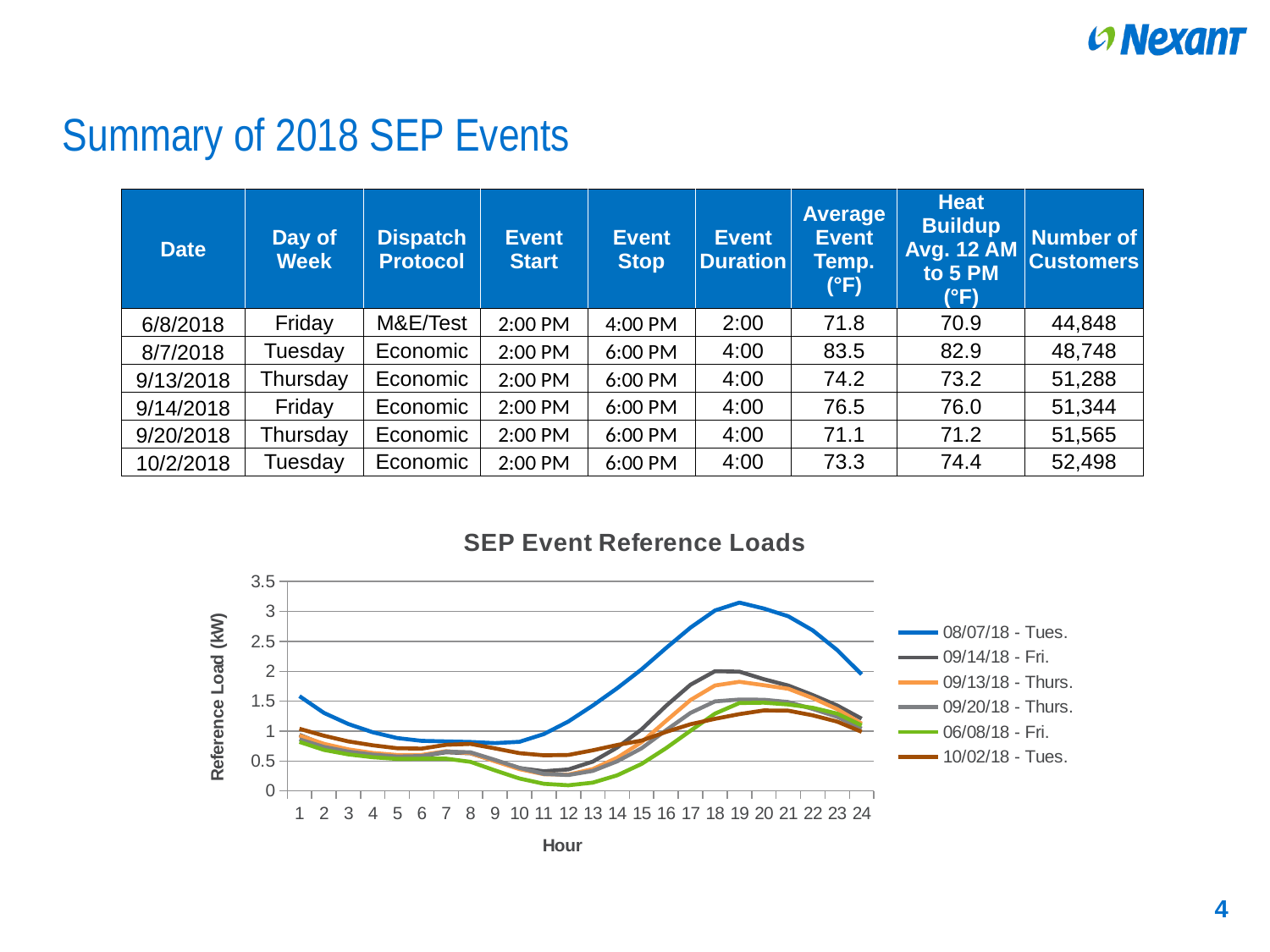
In the "SEP Event Reference Loads" chart, is the reference load for 06/08/18 - Fri. at hour 12 greater or less than 0.5? less What is the label of the y axis in the "SEP Event Reference Loads" chart? Reference Load (kW) In the "SEP Event Reference Loads" chart, which event has the lowest reference load at hour 12? 06/08/18 - Fri. In the "SEP Event Reference Loads" chart, at hour 19, which is larger: the reference load for 08/07/18 - Tues. or for 10/02/18 - Tues.? 08/07/18 - Tues. How many series does the legend of the "SEP Event Reference Loads" chart list? 6 In the "SEP Event Reference Loads" chart, does the reference load for 08/07/18 - Tues. rise or fall from hour 19 to hour 24? fall How many hours are plotted along the x axis of the "SEP Event Reference Loads" chart? 24 What is the label of the x axis in the "SEP Event Reference Loads" chart? Hour In the "SEP Event Reference Loads" chart, which event has the highest reference load at hour 19? 08/07/18 - Tues. In the "SEP Event Reference Loads" chart, is the reference load for 10/02/18 - Tues. at hour 20 greater or less than 1.5? less What kind of chart is "SEP Event Reference Loads"? line chart In the "SEP Event Reference Loads" chart, is the reference load for 08/07/18 - Tues. at hour 19 greater or less than 3? greater